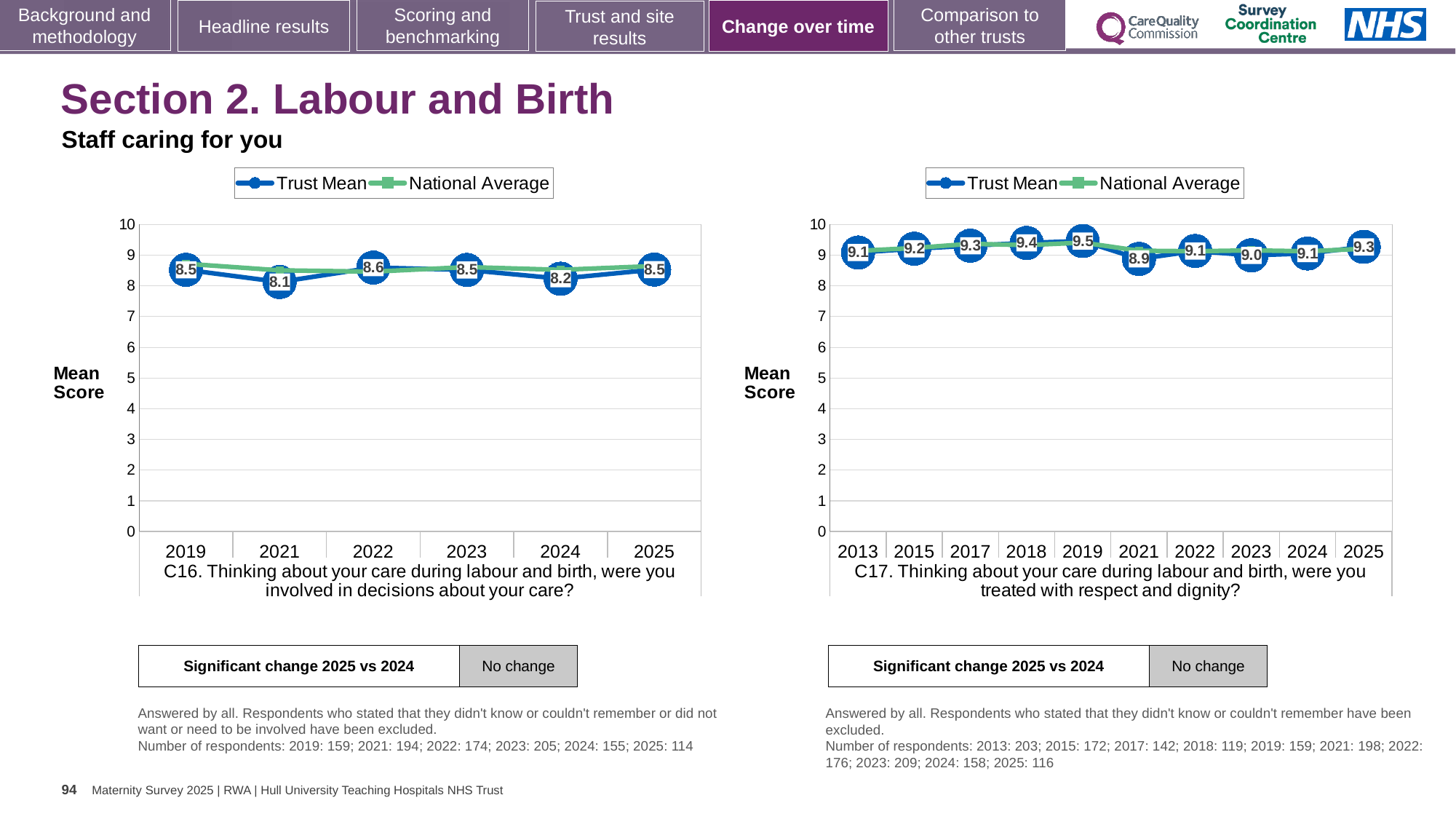
On the C17 chart (right), how many series does the legend list? 2 On the C17 chart (right), which year has the lowest Trust Mean? 2021 On the C16 chart (left), what is the Trust Mean for 2021? 8.1 On the C16 chart (left), what is the difference between the Trust Mean for 2022 and 2021? 0.5 On the C16 chart (left), how many years are plotted on the x axis? 6 On the C16 chart (left), what is the Trust Mean for 2024? 8.2 On the C17 chart (right), is the Trust Mean higher in 2025 or in 2023? 2025 On the C16 chart (left), which year has the lowest Trust Mean? 2021 On the C17 chart (right), what is the Trust Mean for 2019? 9.5 On the C17 chart (right), what is the Trust Mean for 2021? 8.9 On the C17 chart (right), which year has the highest Trust Mean? 2019 What kind of chart is the C16 chart on the left? Line chart